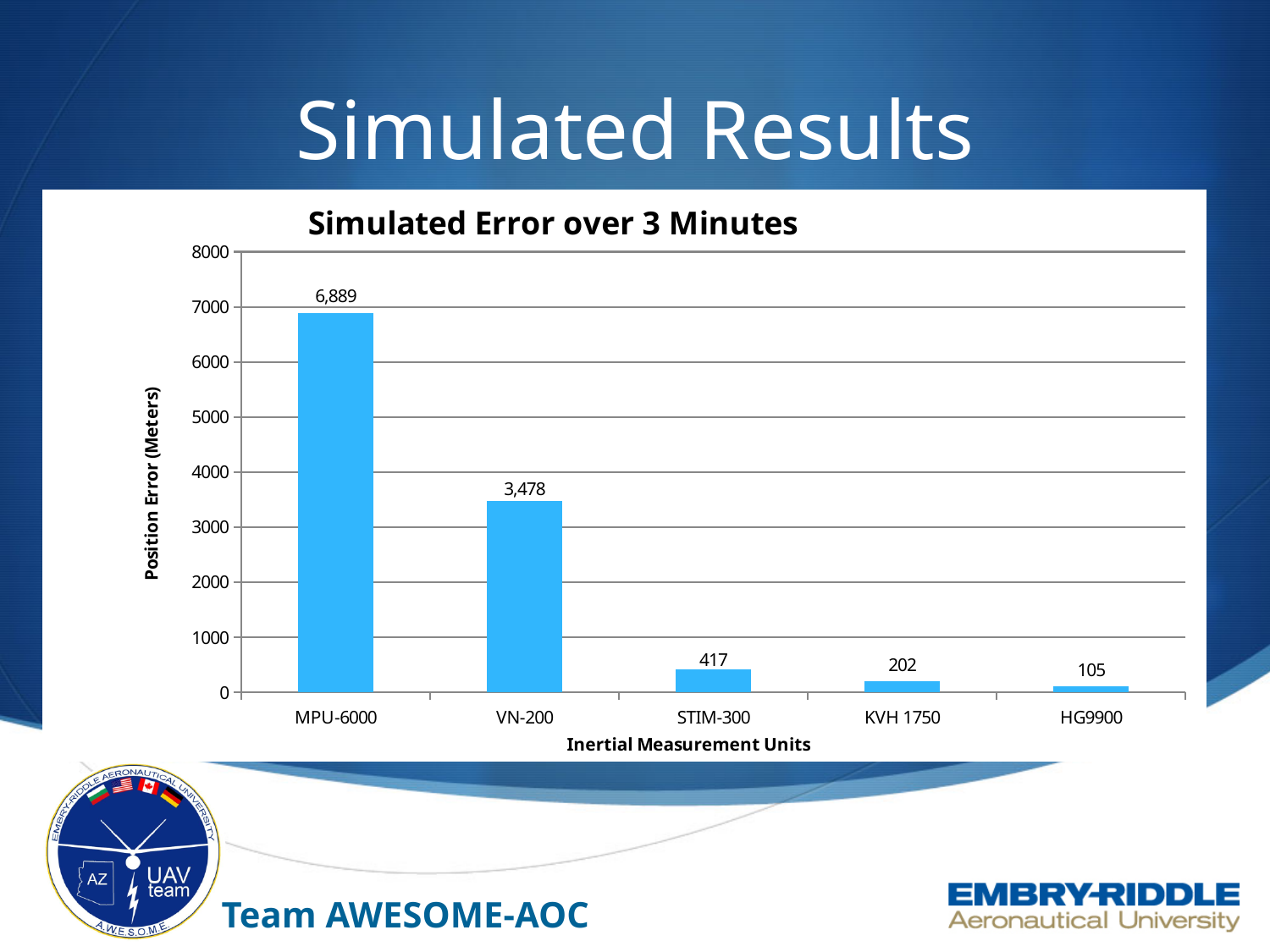
What is the title of the chart? Simulated Error over 3 Minutes What is the position error for the HG9900? 105 What is the position error for the STIM-300? 417 Which has a larger position error, the STIM-300 or the KVH 1750? STIM-300 Which inertial measurement unit has the lowest simulated position error? HG9900 Which inertial measurement unit has the highest simulated position error? MPU-6000 How many inertial measurement units are shown on the chart? 5 What is the position error for the MPU-6000? 6,889 What is the difference in position error between the KVH 1750 and the HG9900? 97 What is the position error for the VN-200? 3,478 What is the difference in position error between the MPU-6000 and the VN-200? 3,411 What kind of chart is shown on the slide? Bar chart